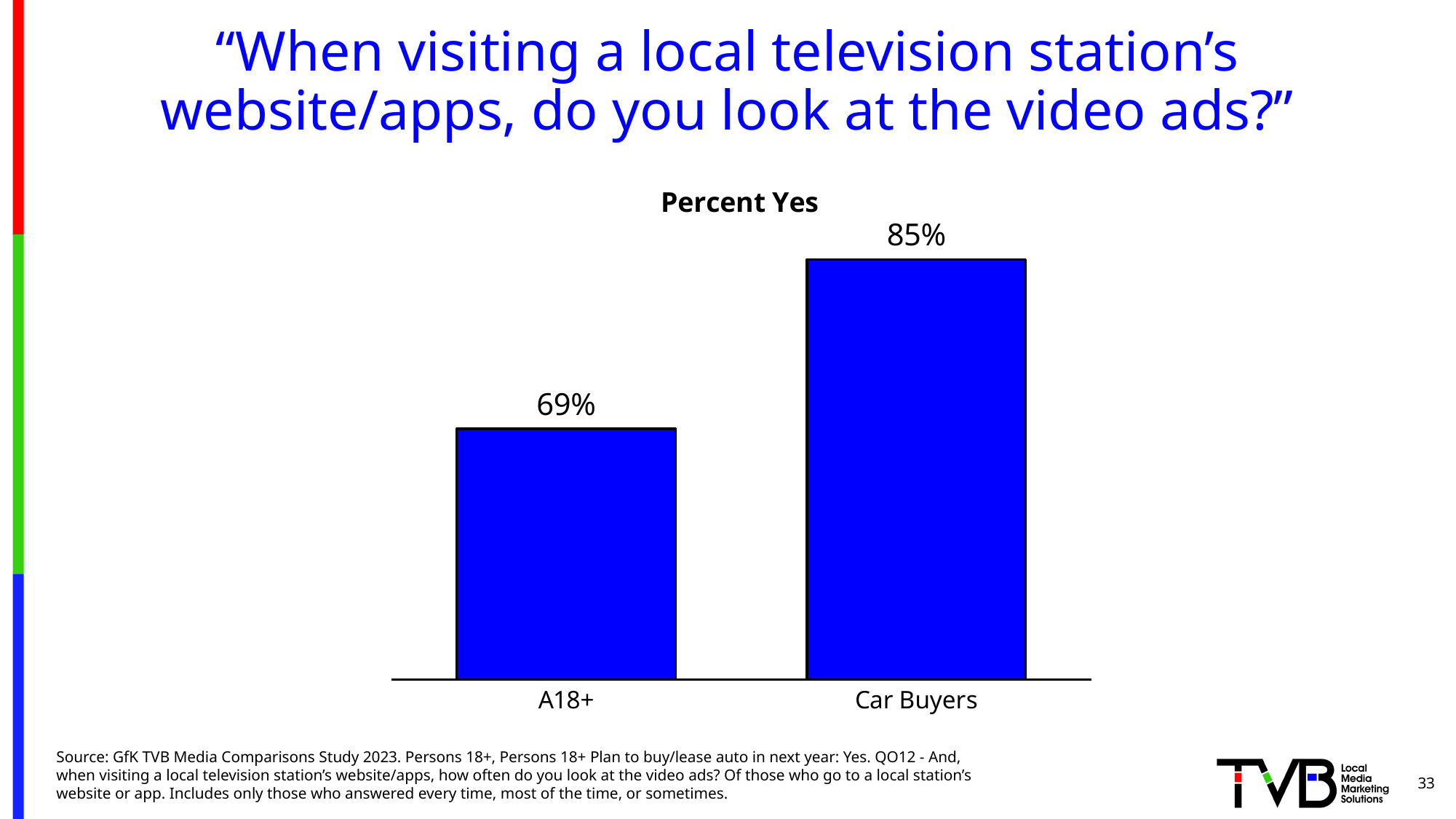
What is the Percent Yes value for A18+? 69% Which category has the higher Percent Yes value? Car Buyers Is the value for Car Buyers larger or smaller than the value for A18+? larger What is the Percent Yes value for Car Buyers? 85% How many categories are shown in the chart? 2 Which category has the lower Percent Yes value? A18+ What colour are the bars in the chart? blue What is the title of the chart? Percent Yes What is the difference in percentage points between Car Buyers and A18+? 16 What kind of chart is shown on the slide? bar chart